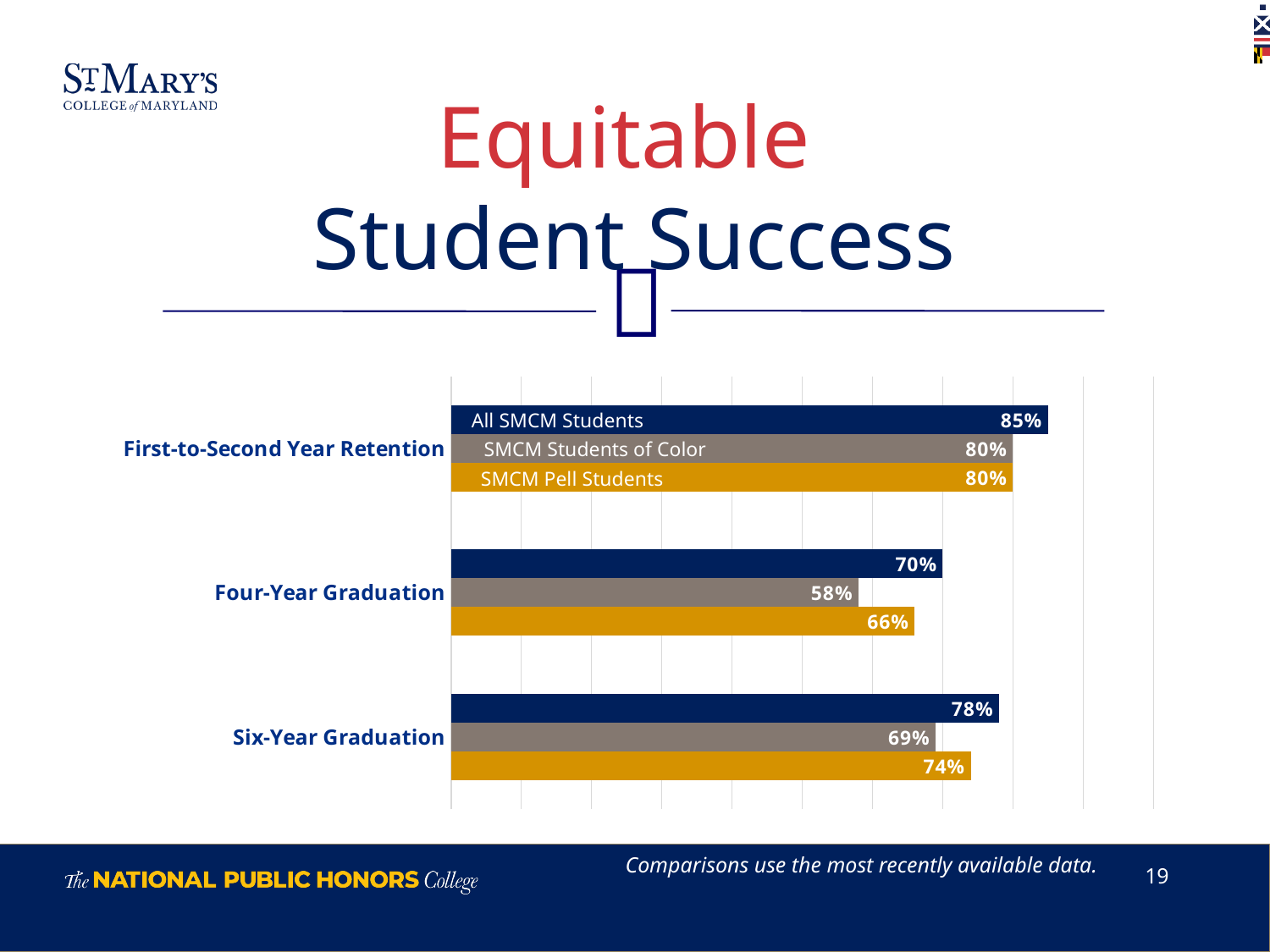
What is the Four-Year Graduation rate for SMCM Pell Students? 66% What is the First-to-Second Year Retention rate for All SMCM Students? 85% Which category has the highest value for All SMCM Students? First-to-Second Year Retention Which is larger: the Six-Year Graduation rate for SMCM Pell Students or for SMCM Students of Color? SMCM Pell Students What is the difference between the Six-Year Graduation rate for All SMCM Students and for SMCM Students of Color? 9% What kind of chart is shown on the slide? Bar chart Which category has the lowest value for SMCM Students of Color? Four-Year Graduation What is the Four-Year Graduation rate for SMCM Students of Color? 58% What is the Six-Year Graduation rate for SMCM Pell Students? 74% What is the difference between the Four-Year Graduation rate for All SMCM Students and for SMCM Pell Students? 4% How many categories are shown on the chart? 3 How many series does the chart show? 3